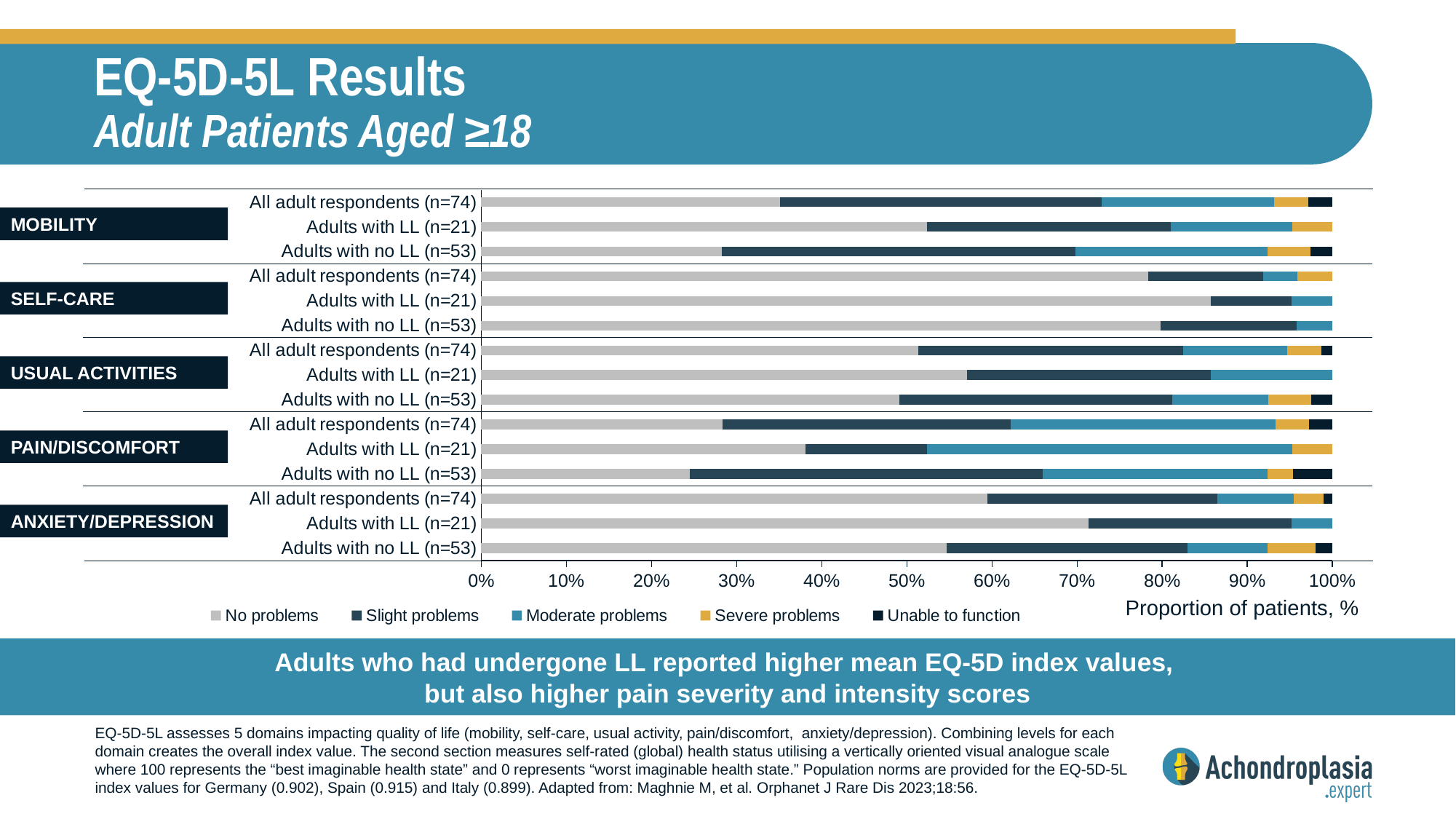
Which legend entry is shown in gold/yellow? Severe problems How many bars are plotted in total on the chart? 15 How many domains (row groups) are shown on the chart? 5 How many series does the legend list? 5 Is the 'No problems' proportion for MOBILITY, All adult respondents (n=74), greater or less than 30%? greater What kind of chart is shown on the slide? Stacked bar chart Is the 'No problems' proportion for PAIN/DISCOMFORT, Adults with no LL (n=53), greater or less than 30%? less Is the 'No problems' proportion for USUAL ACTIVITIES, Adults with LL (n=21), greater or less than 50%? greater In the MOBILITY domain, which group has the larger 'No problems' proportion: Adults with LL (n=21) or Adults with no LL (n=53)? Adults with LL (n=21) What is the title of the x axis? Proportion of patients, %